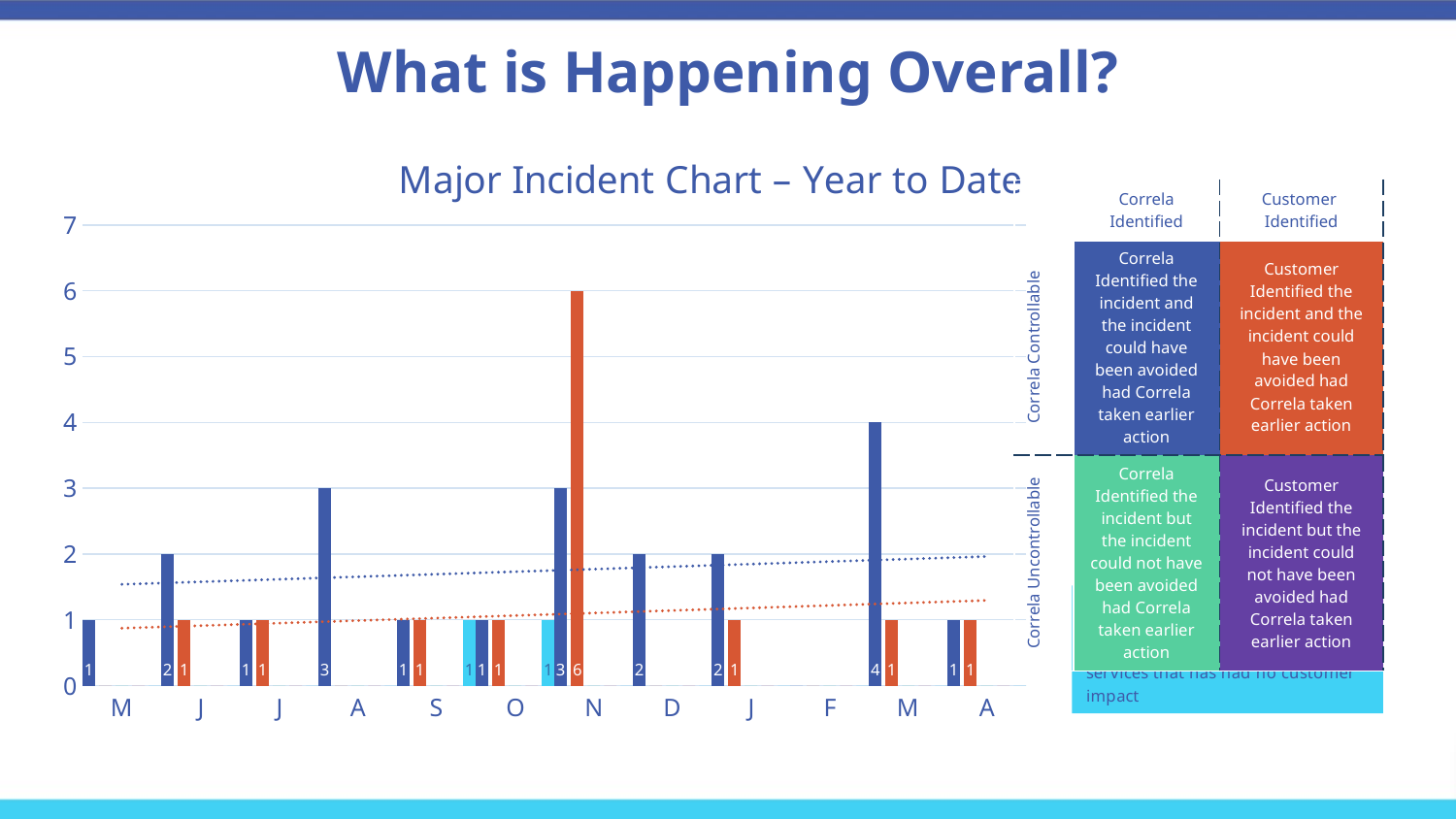
What is the value of the dark blue bar for the first month labelled A on the x axis? 3 What is the value of the dark blue bar for the month labelled N? 3 What is the highest value of any bar in the chart? 6 How many month labels are shown along the x axis of the chart? 12 What is the value of the orange bar for the month labelled N? 6 What is the value of the dark blue bar for the second month labelled M on the x axis? 4 Is the orange bar for the month labelled N greater or less than 5? greater Which month label on the x axis has no bars plotted? F What is the difference between the orange bar and the dark blue bar for the month labelled N? 3 Which is larger: the dark blue bar for the second M or the dark blue bar for the first A? the second M What kind of chart is the Major Incident Chart – Year to Date? bar chart What is the title of the chart on the slide? Major Incident Chart – Year to Date